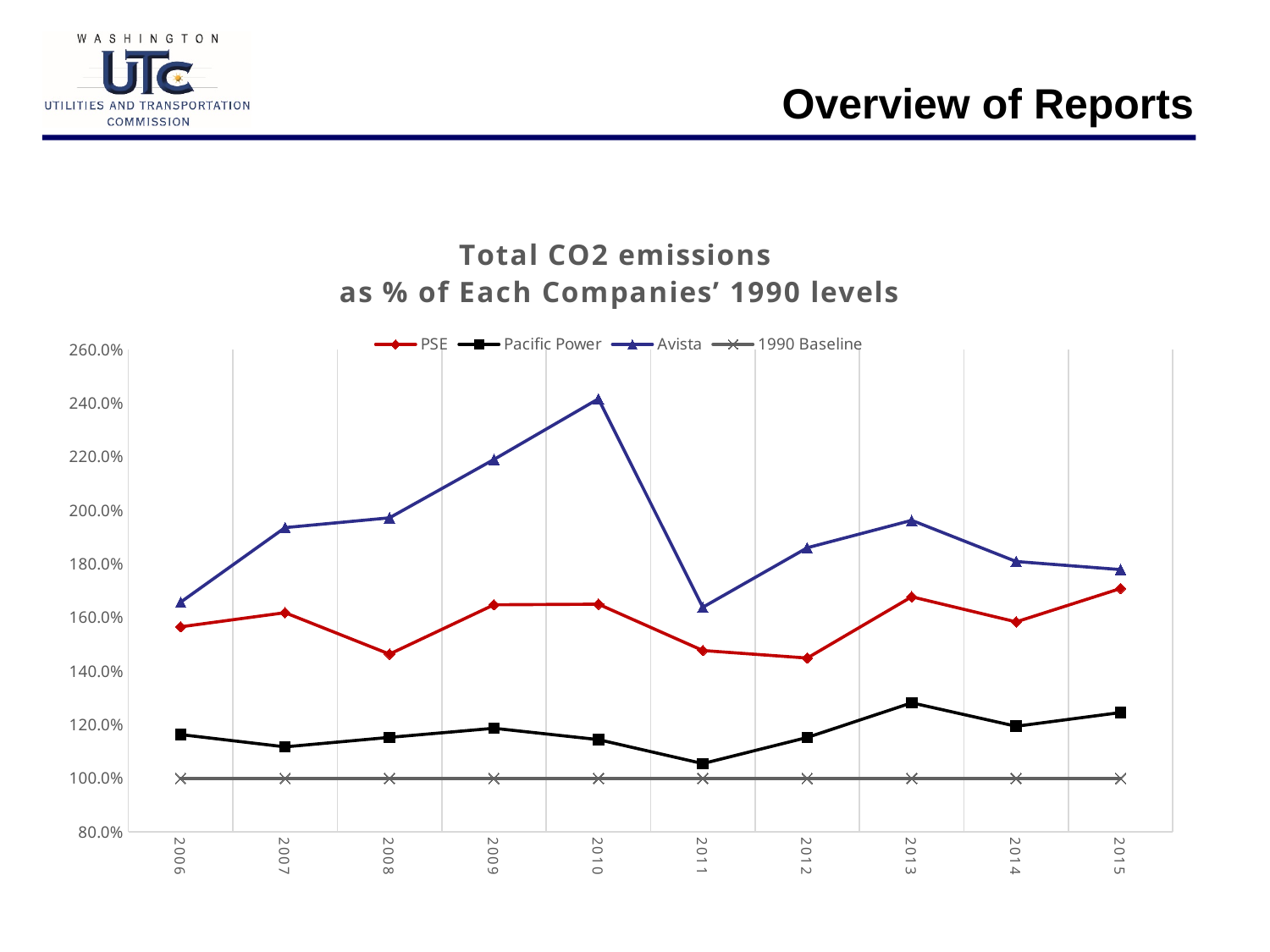
In which year does the Avista series reach its highest value? 2010 In which year does the Pacific Power series reach its lowest value? 2011 Is the value for Avista in 2010 greater or less than 220.0%? greater Is the value for Avista in 2011 greater or less than 180.0%? less In which year does the Pacific Power series reach its highest value? 2013 How many years are plotted along the x axis? 10 Does the Avista series rise or fall from 2006 to 2010? rise What kind of chart is shown on the slide? line chart Is the value for PSE in 2006 greater or less than 160.0%? less What is the value of the 1990 Baseline series in 2012? 100.0% How many series does the legend list? 4 Which series has the larger value in 2010, Avista or PSE? Avista